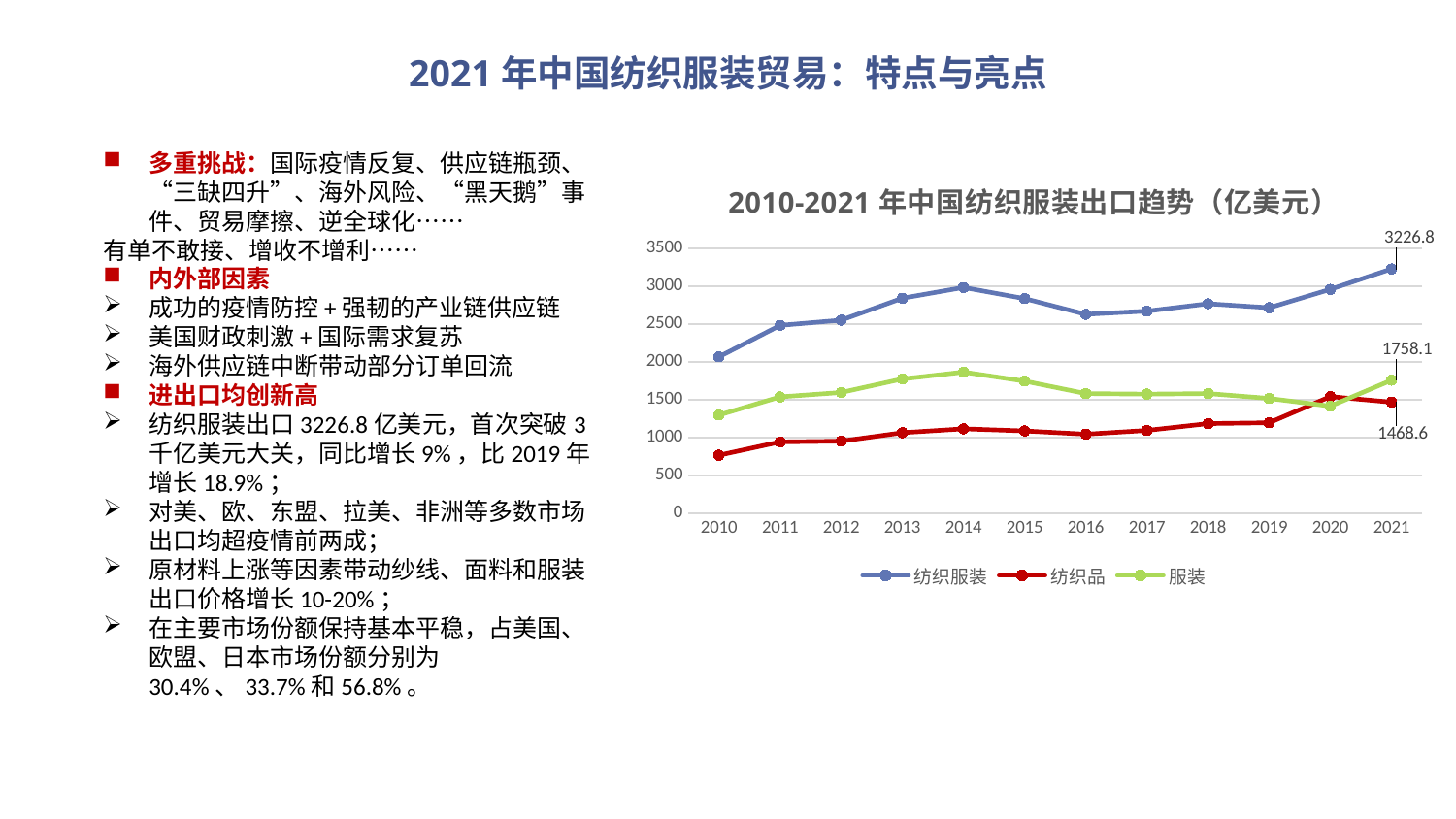
In which year does the 纺织服装 series reach its highest value? 2021 What is the value of 纺织品 in 2021? 1468.6 What is the value of 纺织服装 in 2021? 3226.8 What is the difference between the 2021 values of 服装 and 纺织品? 289.5 How many series does the legend list? 3 Is the value for 服装 in 2014 greater or less than 1500? greater Is the value for 纺织品 in 2010 greater or less than 1000? less In 2019, which is larger, 服装 or 纺织品? 服装 What is the title of the chart? 2010-2021 年中国纺织服装出口趋势（亿美元） How many years are shown on the x axis of the chart? 12 What is the value of 服装 in 2021? 1758.1 What kind of chart is shown on the slide? line chart